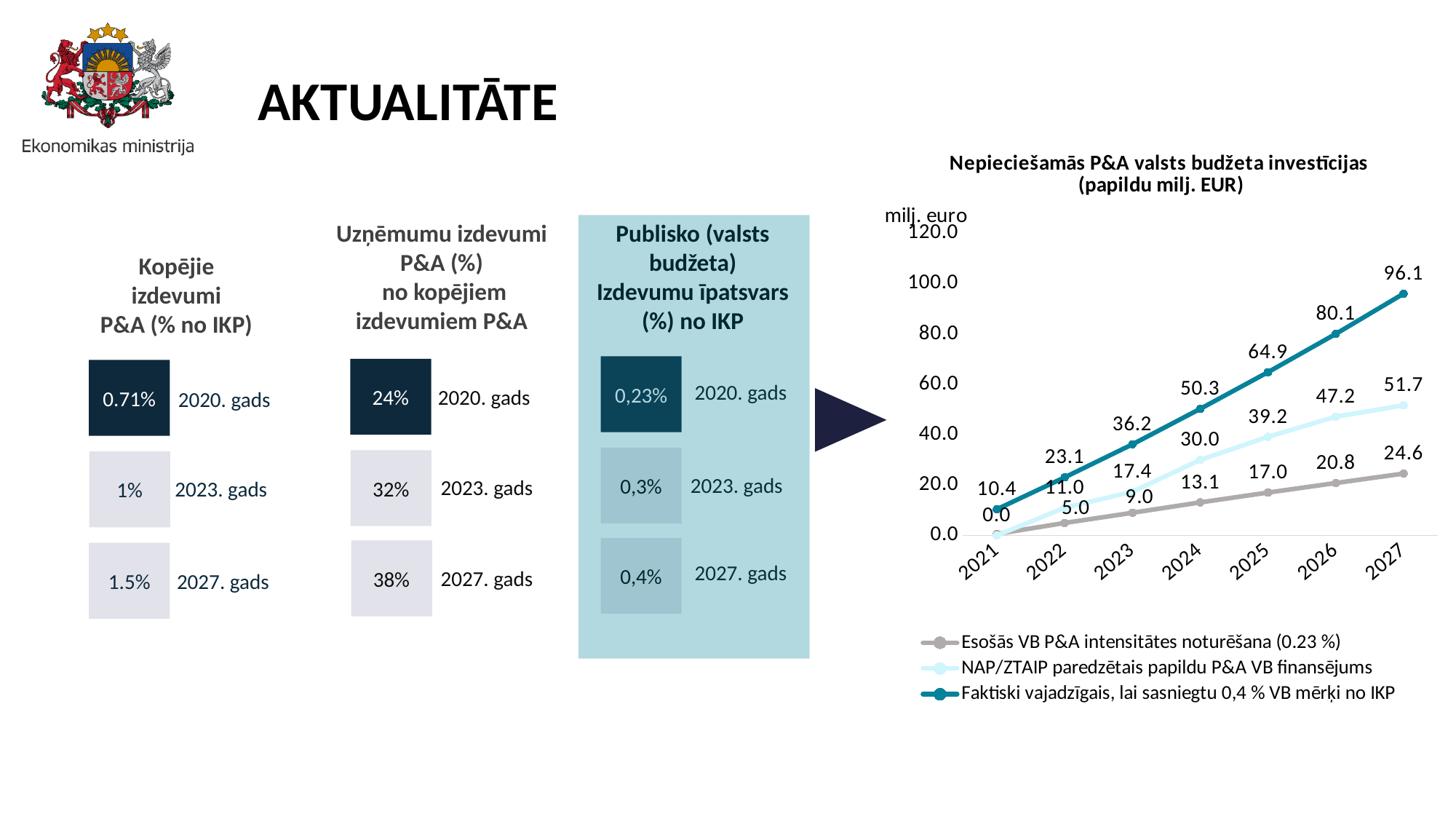
Which series has the larger value in 2025: 'NAP/ZTAIP paredzētais papildu P&A VB finansējums' or 'Esošās VB P&A intensitātes noturēšana (0.23 %)'? NAP/ZTAIP paredzētais papildu P&A VB finansējums What is the value for 2027 in the series 'Faktiski vajadzīgais, lai sasniegtu 0,4 % VB mērķi no IKP'? 96.1 What is the title of the chart on the slide? Nepieciešamās P&A valsts budžeta investīcijas (papildu milj. EUR) What is the difference between the 2027 values of the 'Faktiski vajadzīgais' series (96.1) and the 'NAP/ZTAIP' series (51.7)? 44.4 What unit label is shown at the top of the chart's vertical axis? milj. euro What is the value for 2024 in the series 'NAP/ZTAIP paredzētais papildu P&A VB finansējums'? 30.0 What type of chart is shown on the slide? line chart What is the value for 2026 in the series 'Esošās VB P&A intensitātes noturēšana (0.23 %)'? 20.8 How many series does the chart legend list? 3 How many years are plotted along the x axis of the chart? 7 Do the values of the 'Esošās VB P&A intensitātes noturēšana (0.23 %)' series rise or fall from 2022 to 2027? rise In which year does the series 'Faktiski vajadzīgais, lai sasniegtu 0,4 % VB mērķi no IKP' reach its highest value? 2027